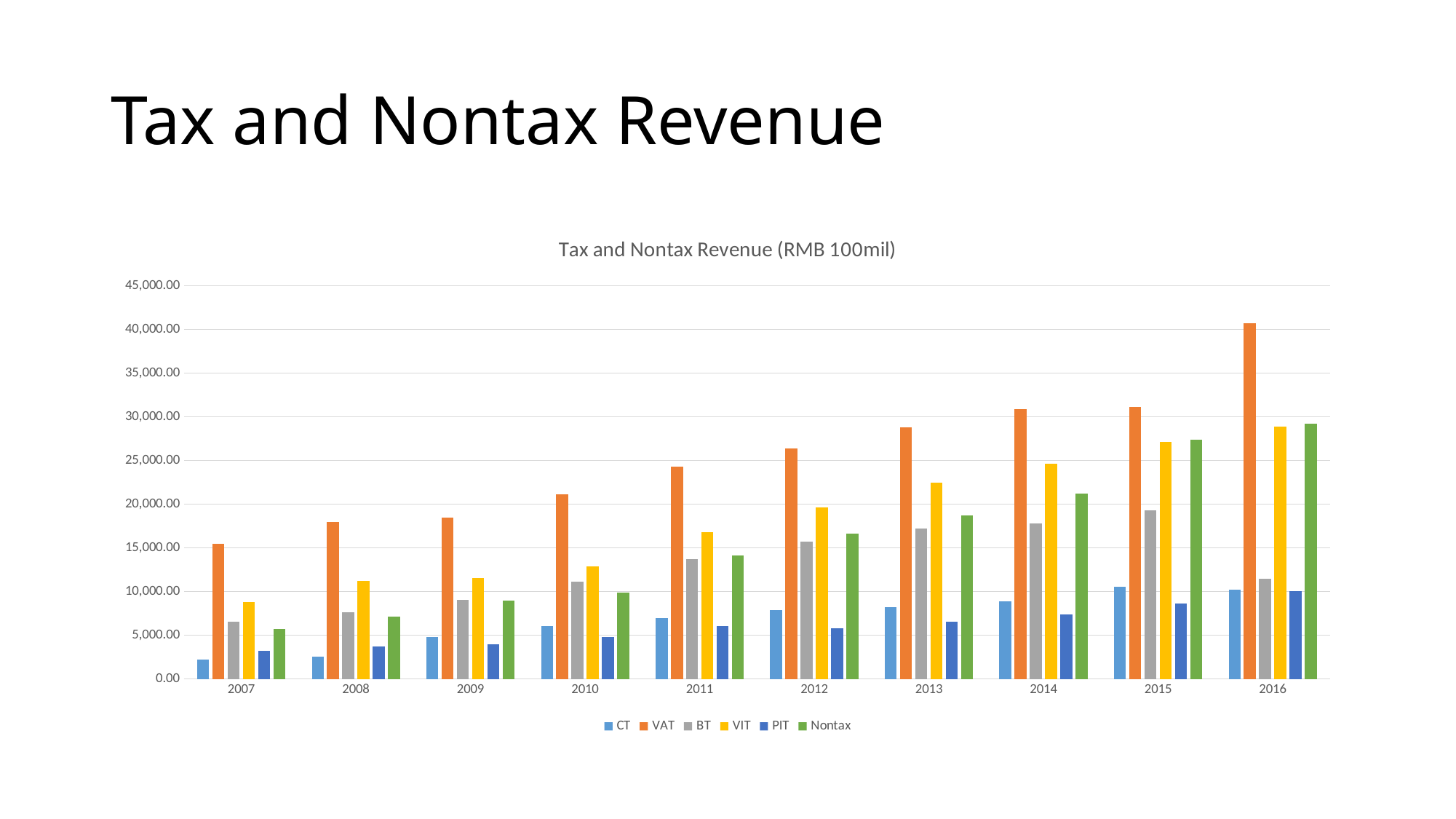
Which is larger in 2015, VIT or BT? VIT Which series has the lowest value in 2007? CT What is the title of the chart? Tax and Nontax Revenue (RMB 100mil) Which is larger in 2016, Nontax or BT? Nontax Is the CT value for 2015 greater or less than 10,000.00? greater Does the VAT series rise or fall from 2007 to 2016? rise How many years are shown on the x axis? 10 Is the Nontax value for 2007 greater or less than 10,000.00? less How many series does the legend list? 6 Which series has the highest value in 2016? VAT Is the VAT value for 2016 greater or less than 40,000.00? greater What kind of chart is shown on the slide? bar chart